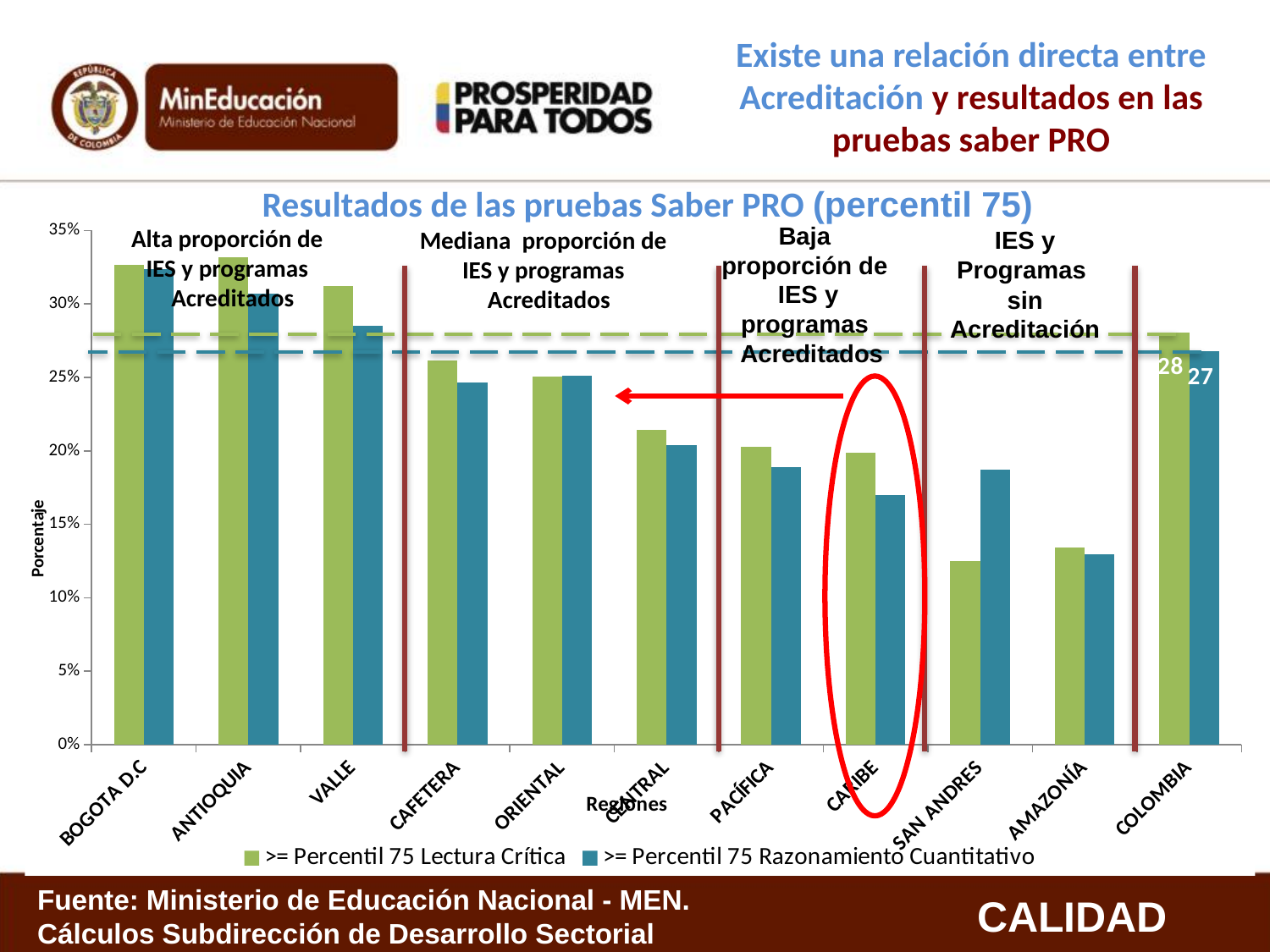
For SAN ANDRES, which series has the larger value: Lectura Crítica or Razonamiento Cuantitativo? Razonamiento Cuantitativo Which region has the highest value for '>= Percentil 75 Razonamiento Cuantitativo'? BOGOTA D.C Is the '>= Percentil 75 Lectura Crítica' value for VALLE greater or less than 30%? greater What is the value for COLOMBIA in the '>= Percentil 75 Razonamiento Cuantitativo' series? 27 Which region has the lowest value for '>= Percentil 75 Lectura Crítica'? SAN ANDRES How many series does the legend list? 2 How many regions (categories) are shown on the x axis? 11 What is the value for COLOMBIA in the '>= Percentil 75 Lectura Crítica' series? 28 Which region has the lowest value for '>= Percentil 75 Razonamiento Cuantitativo'? AMAZONÍA What kind of chart is shown on the slide? Bar chart Is the '>= Percentil 75 Razonamiento Cuantitativo' value for CARIBE greater or less than 20%? less What is the title of the chart? Resultados de las pruebas Saber PRO (percentil 75)